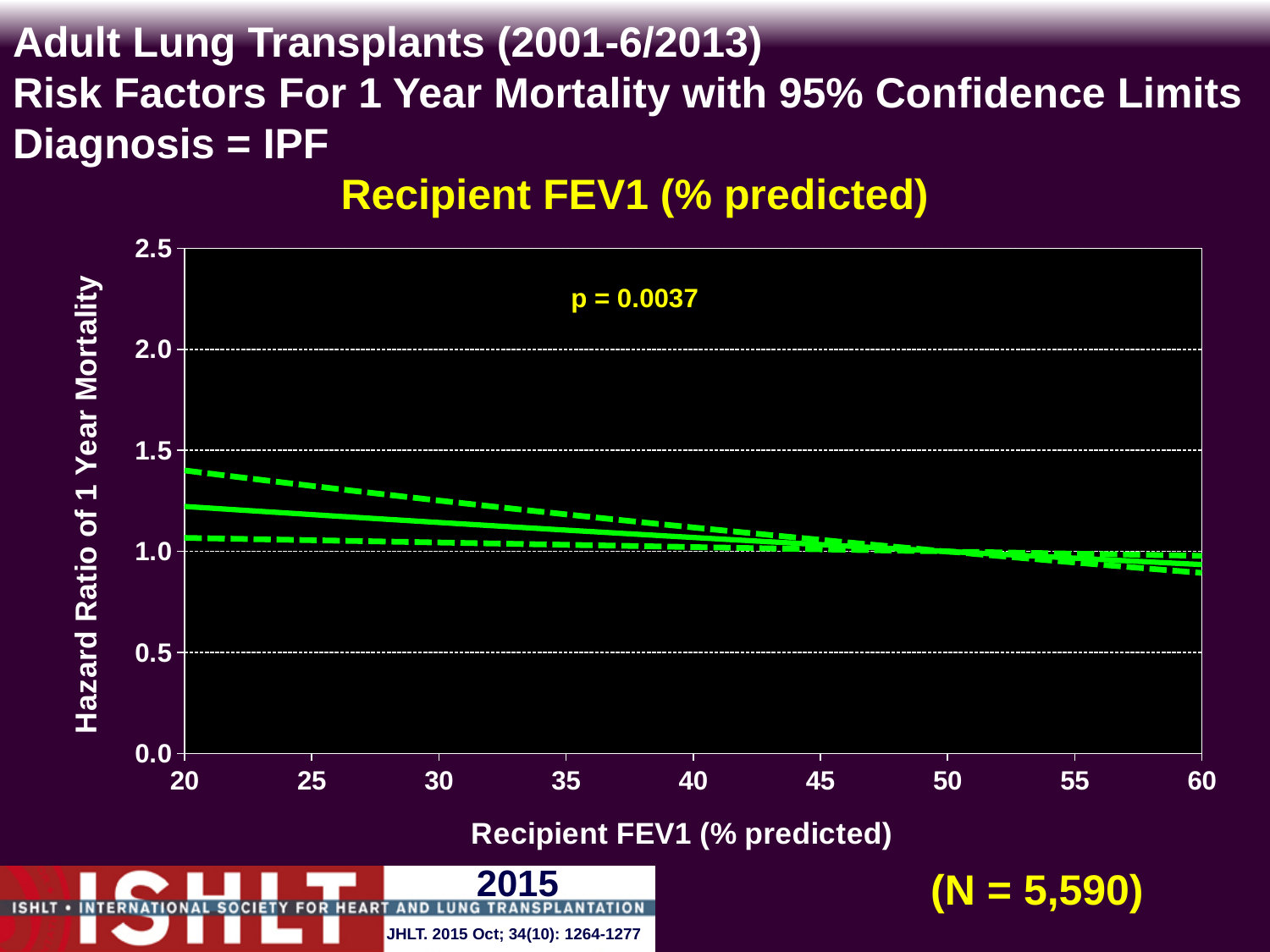
How many lines are plotted on the chart? 3 What is the sample size (N) shown on the slide? N = 5,590 Is the lower 95% confidence limit (lower dashed line) at a Recipient FEV1 of 60% predicted greater or less than 1.0? less What is the highest value shown on the y-axis? 2.5 Is the hazard ratio shown by the solid line at a Recipient FEV1 of 30% predicted greater or less than 1.0? greater Is the hazard ratio shown by the solid line at a Recipient FEV1 of 20% predicted greater or less than 1.5? less What kind of chart is shown on the slide? line chart What is the p-value printed on the chart? p = 0.0037 Does the hazard ratio of 1 year mortality rise or fall as Recipient FEV1 (% predicted) increases from 20 to 60? fall